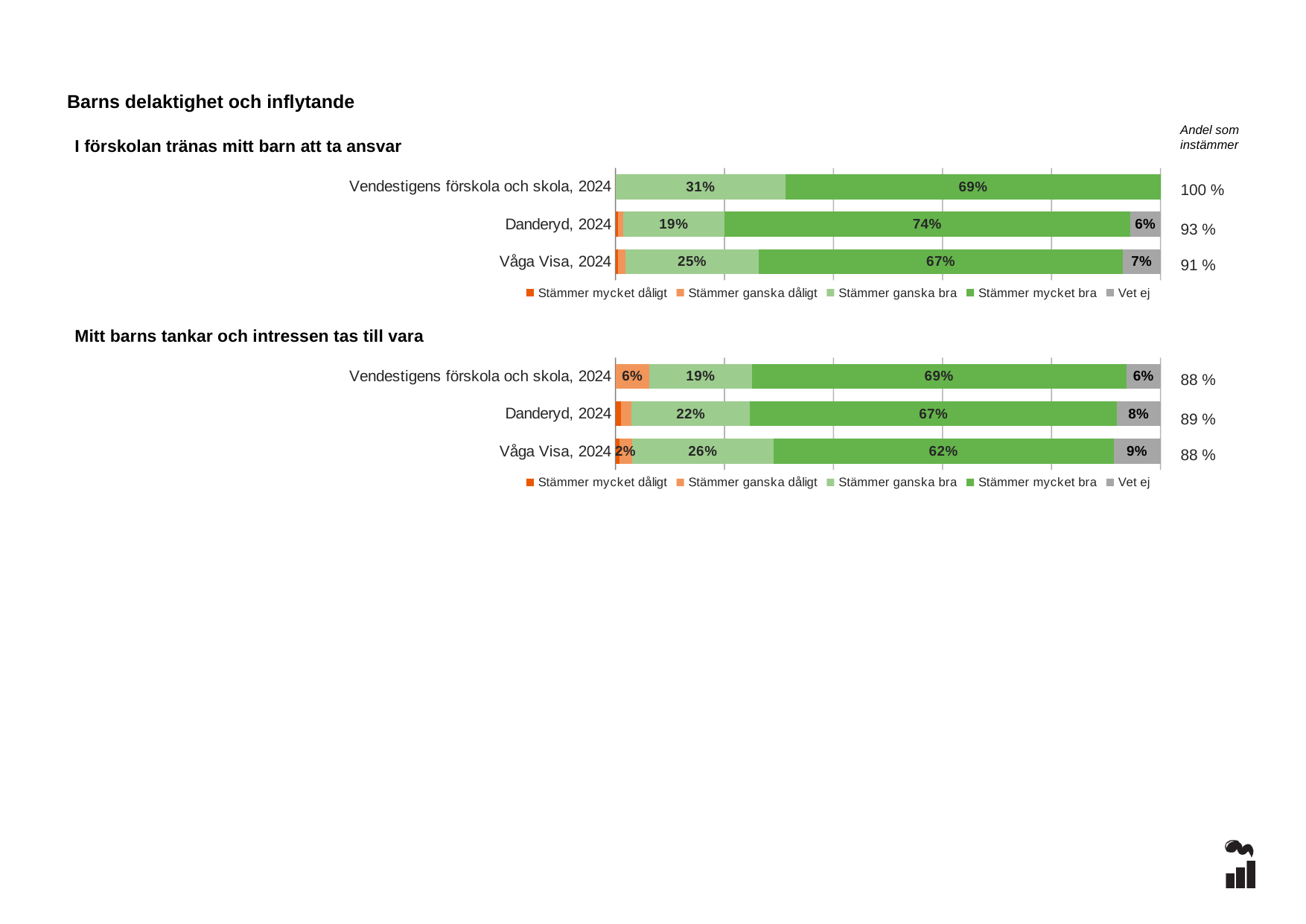
In the chart 'Mitt barns tankar och intressen tas till vara', what is the 'Vet ej' value for Våga Visa, 2024? 9% What kind of chart is 'Mitt barns tankar och intressen tas till vara'? Stacked bar chart In the chart 'Mitt barns tankar och intressen tas till vara', which row has the lowest 'Stämmer mycket bra' value? Våga Visa, 2024 In the chart 'Mitt barns tankar och intressen tas till vara', what is the 'Stämmer ganska dåligt' value for Vendestigens förskola och skola, 2024? 6% In the chart 'Mitt barns tankar och intressen tas till vara', what is the 'Andel som instämmer' for Danderyd, 2024? 89 % How many series does the legend of the chart 'I förskolan tränas mitt barn att ta ansvar' list? 5 In the chart 'I förskolan tränas mitt barn att ta ansvar', what is the 'Andel som instämmer' for Våga Visa, 2024? 91 % In the chart 'I förskolan tränas mitt barn att ta ansvar', what is the difference between the 'Stämmer mycket bra' values for Danderyd, 2024 and Våga Visa, 2024? 7 percentage points In the chart 'I förskolan tränas mitt barn att ta ansvar', what is the 'Stämmer mycket bra' value for Danderyd, 2024? 74% In the chart 'I förskolan tränas mitt barn att ta ansvar', what is the 'Stämmer ganska bra' value for Vendestigens förskola och skola, 2024? 31% In the chart 'I förskolan tränas mitt barn att ta ansvar', which row has the highest 'Stämmer mycket bra' value? Danderyd, 2024 In the chart 'Mitt barns tankar och intressen tas till vara', is the 'Stämmer ganska bra' value larger for Danderyd, 2024 or for Vendestigens förskola och skola, 2024? Danderyd, 2024